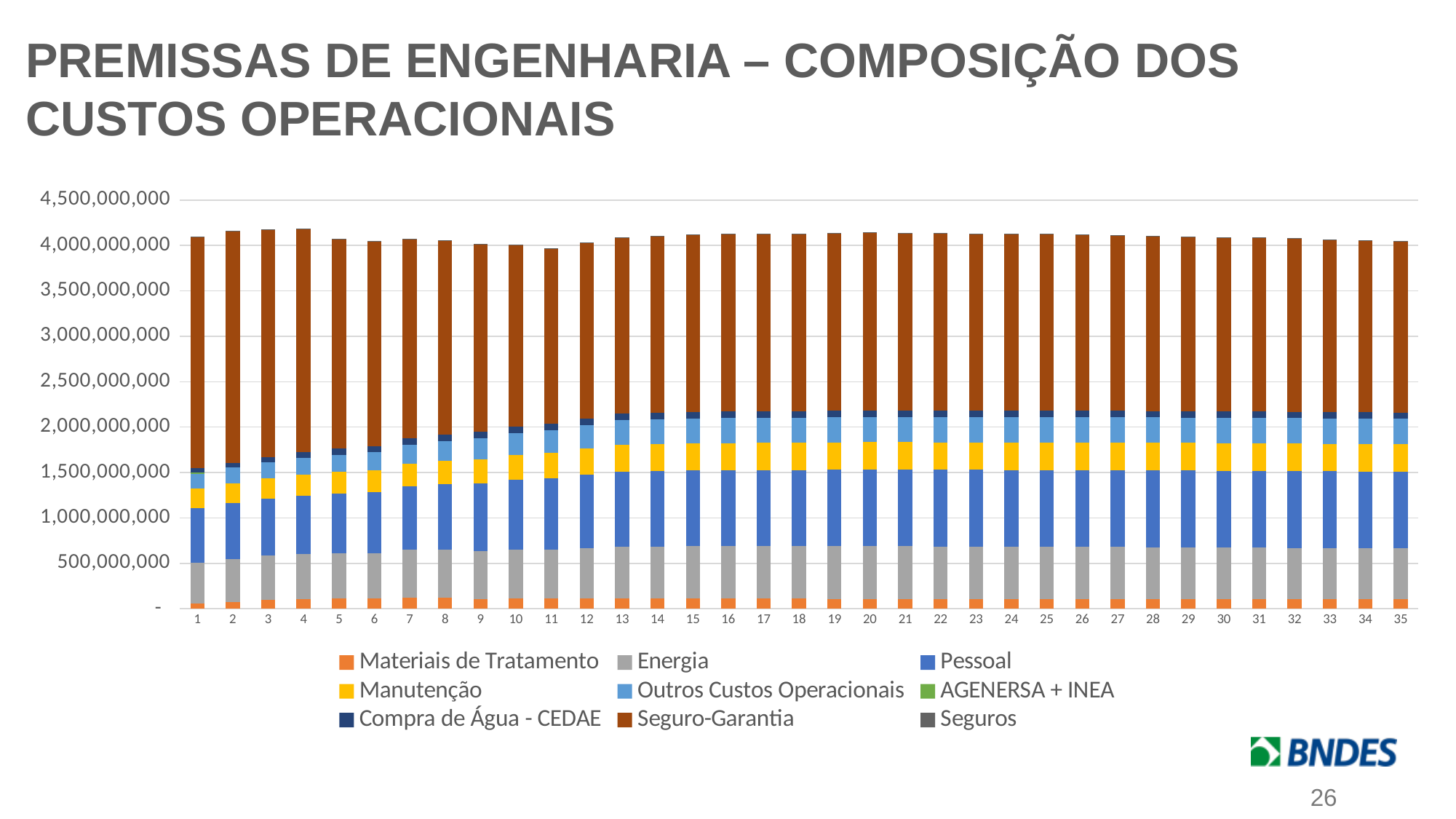
How many categories (bars) are plotted along the x axis? 35 What colour represents the Seguro-Garantia series? Brown How many series does the legend list? 9 Is the top of the Energia segment in category 20 greater or less than 1,000,000,000? less Is the top of the Pessoal segment in category 20 greater or less than 1,000,000,000? greater Is the total for category 1 greater or less than 4,500,000,000? less Does the Pessoal segment grow or shrink from category 1 to category 10? Grows Which has the larger total, category 4 or category 11? Category 4 Which series occupies the largest portion of each stacked bar? Seguro-Garantia What kind of chart is shown on the slide? Stacked bar chart